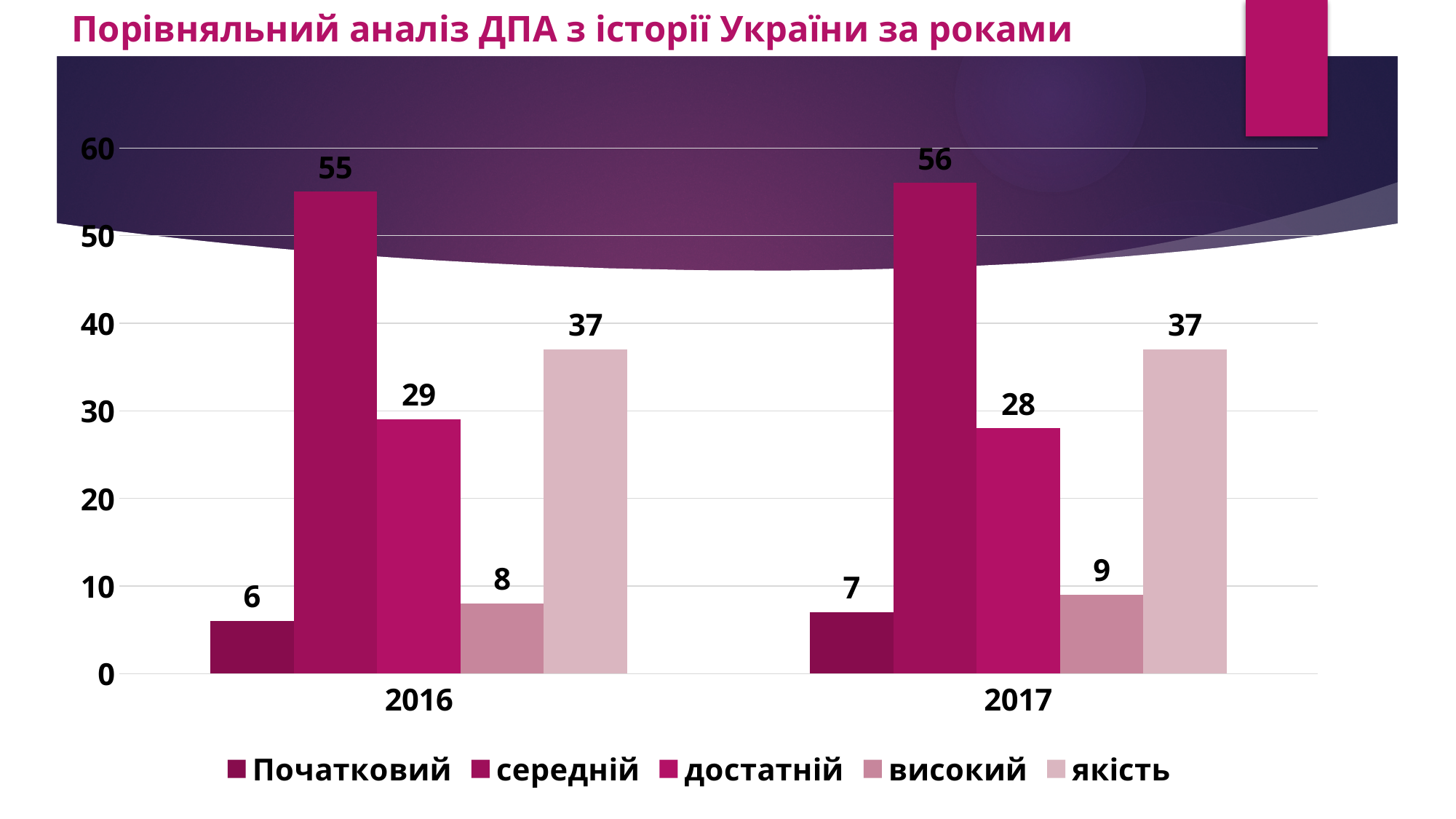
How many years are shown on the x axis? 2 What is the value for достатній in 2017? 28 What kind of chart is shown on the slide? bar chart Is the value for достатній in 2016 greater or less than 20? greater Which series has the highest value in 2017? середній Which series has the lowest value in 2016? Початковий What is the value for якість in 2016? 37 What is the value for середній in 2016? 55 How many series does the legend list? 5 Which is larger: високий in 2016 or високий in 2017? високий in 2017 What is the value for Початковий in 2017? 7 What is the difference between the середній values for 2017 and 2016? 1